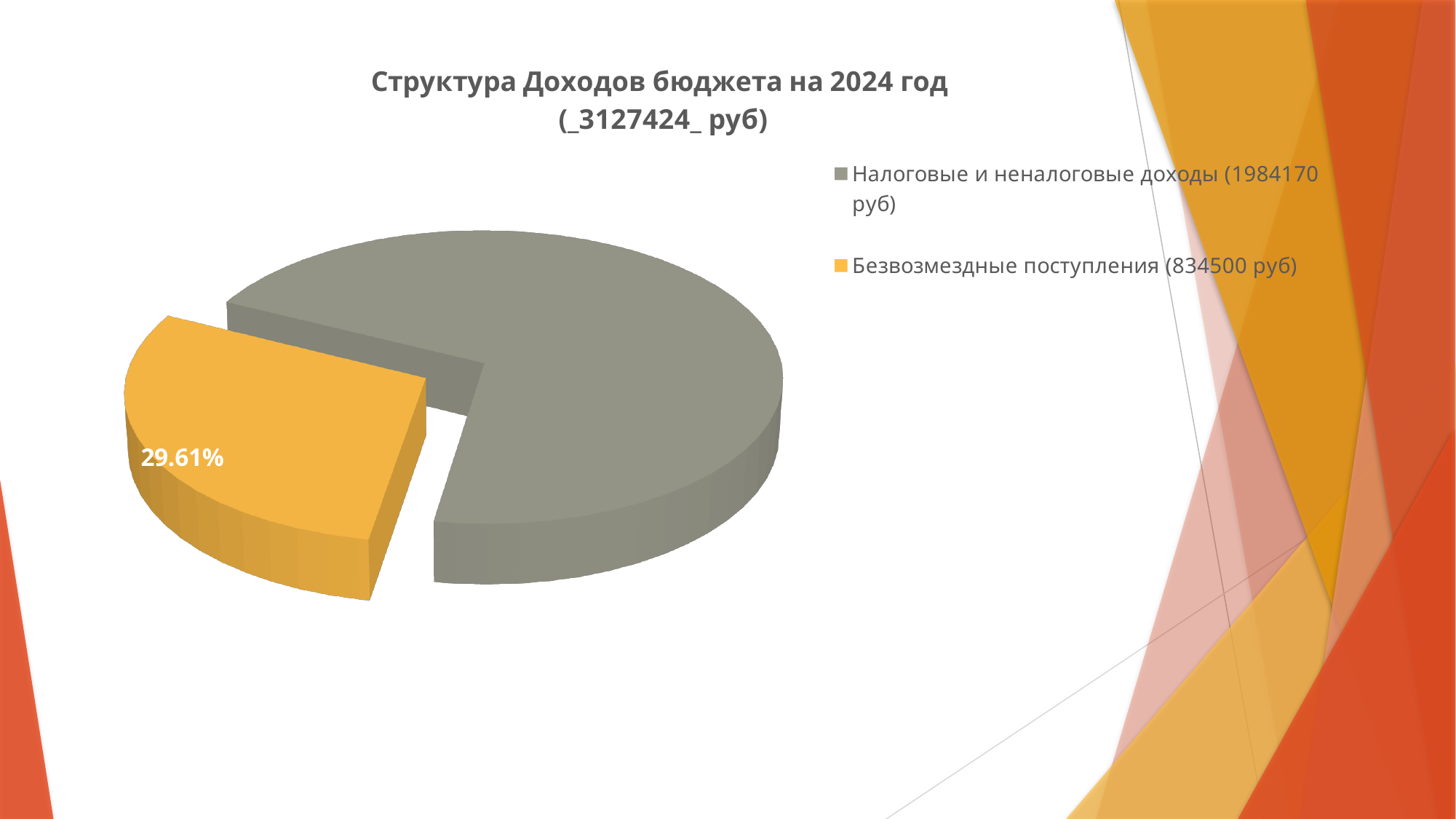
What colour is the slice for Безвозмездные поступления? orange What amount is given in the legend for Безвозмездные поступления? 834500 руб What percentage is printed on the slice for Безвозмездные поступления? 29.61% What is the title of the chart? Структура Доходов бюджета на 2024 год (_3127424_ руб) By how much does the amount for Налоговые и неналоговые доходы exceed the amount for Безвозмездные поступления, according to the legend? 1149670 руб What amount is given in the legend for Налоговые и неналоговые доходы? 1984170 руб How many slices does the pie chart have? 2 How many entries does the legend list? 2 Which category has the largest slice of the pie? Налоговые и неналоговые доходы Which category has the smallest slice of the pie? Безвозмездные поступления Which is larger: Налоговые и неналоговые доходы or Безвозмездные поступления? Налоговые и неналоговые доходы What kind of chart is shown on the slide? pie chart